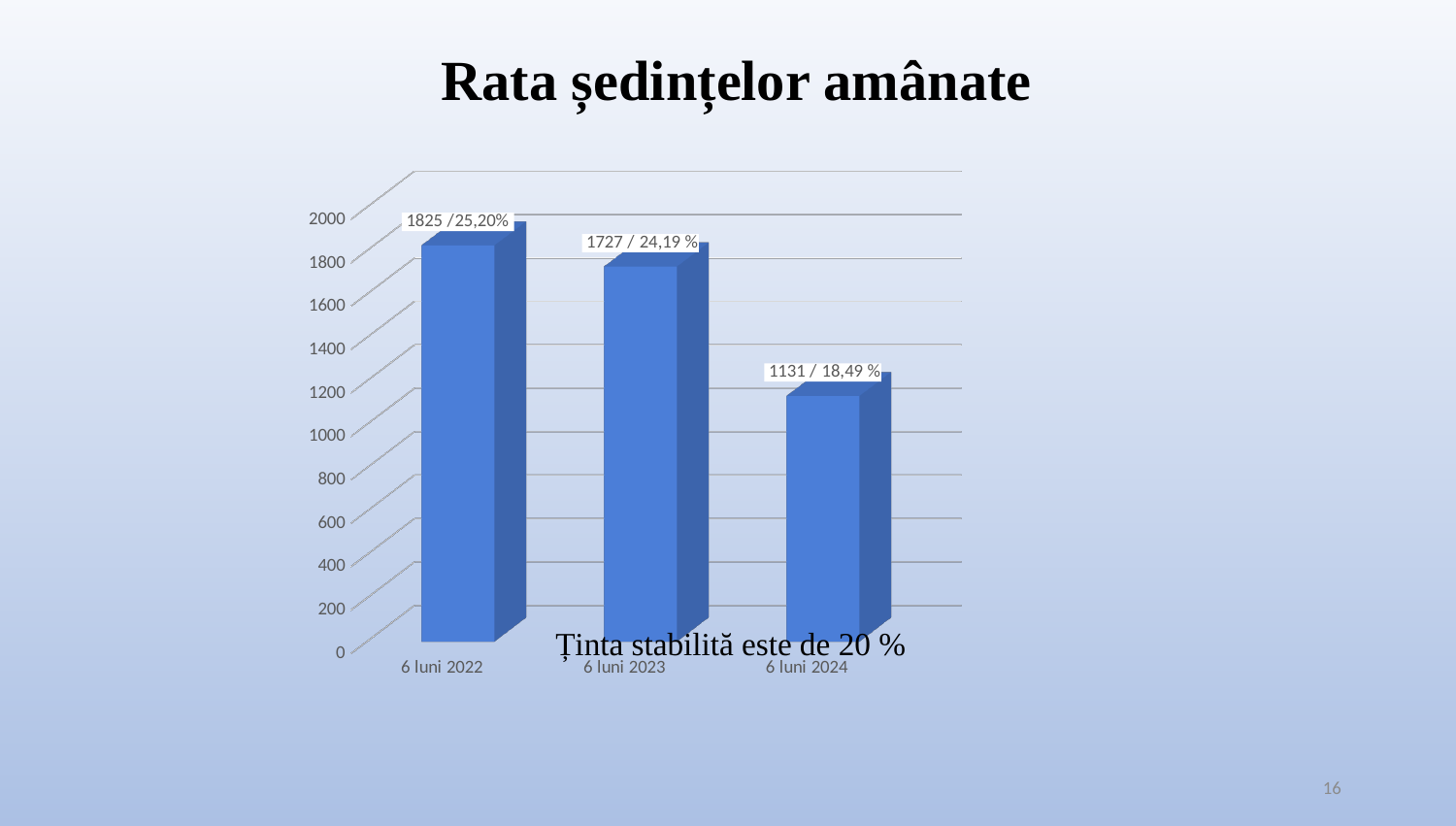
What is the difference between the count for 6 luni 2022 (1825) and the count for 6 luni 2023 (1727)? 98 What is the data label shown for 6 luni 2022? 1825 /25,20% Which category has the highest bar? 6 luni 2022 What kind of chart is shown on the slide? bar chart What is the data label shown for 6 luni 2024? 1131 / 18,49 % How many categories are shown on the x axis? 3 Which category has the lowest bar? 6 luni 2024 Which is larger, the value for 6 luni 2023 or the value for 6 luni 2024? 6 luni 2023 Is the value for 6 luni 2024 greater or less than 1200? less What is the data label shown for 6 luni 2023? 1727 / 24,19 % Do the values rise or fall from 6 luni 2022 to 6 luni 2024? fall What is the difference between the count for 6 luni 2022 (1825) and the count for 6 luni 2024 (1131)? 694